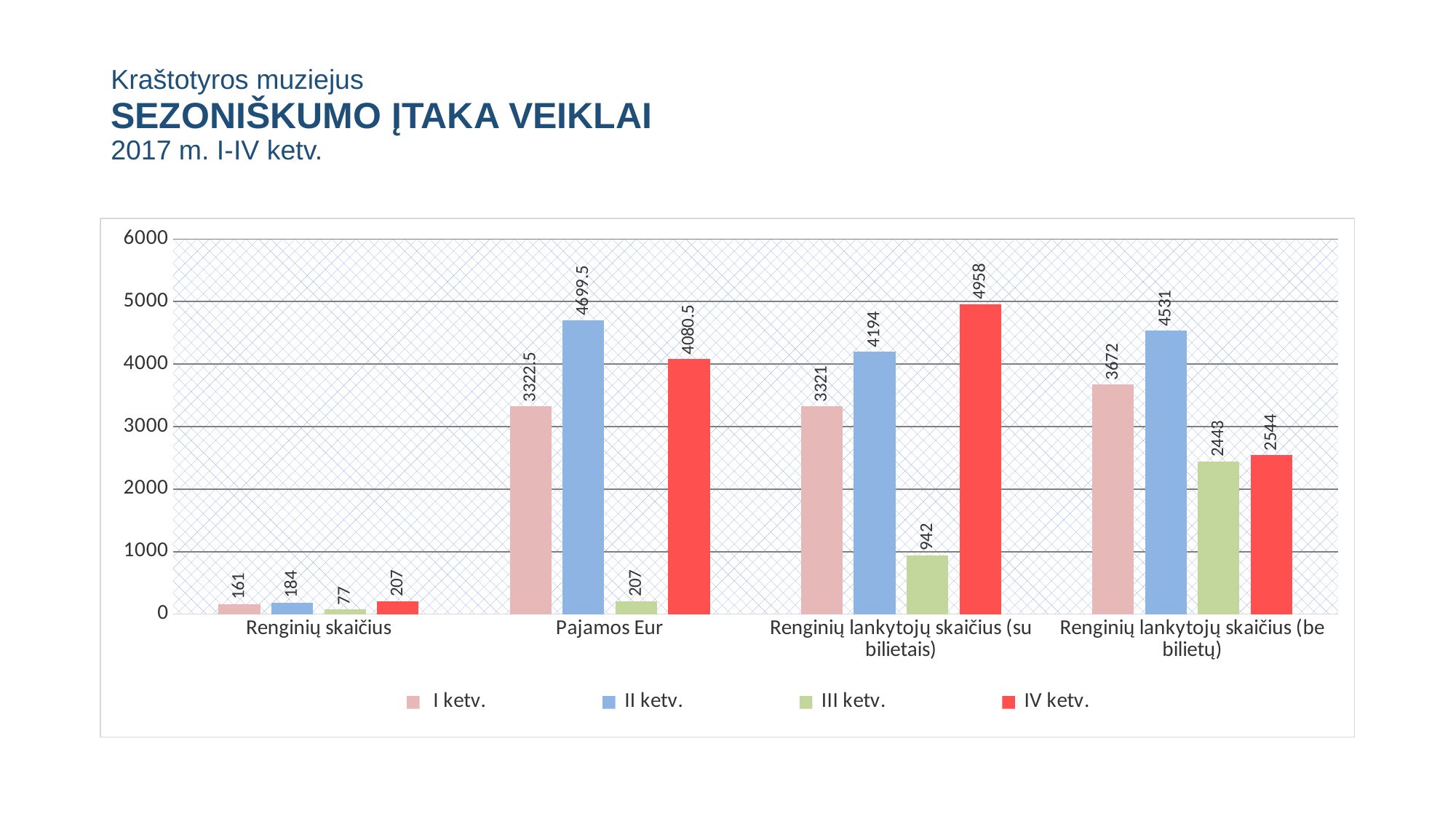
Which quarter has the lowest value in the Pajamos Eur category? III ketv. What is the difference between the II ketv. and I ketv. values in the Renginių lankytojų skaičius (be bilietų) category? 859 How many categories are shown on the x axis? 4 Which quarter has the highest value in the Renginių lankytojų skaičius (su bilietais) category? IV ketv. What kind of chart is shown on the slide? bar chart What is the value for IV ketv. in the Renginių skaičius category? 207 What is the value for III ketv. in the Renginių lankytojų skaičius (su bilietais) category? 942 How many series does the legend list? 4 What is the value for II ketv. in the Pajamos Eur category? 4699.5 What colour represents IV ketv. in the chart? red In the Pajamos Eur category, which is larger: the I ketv. value or the IV ketv. value? IV ketv. Is the value for II ketv. in the Renginių lankytojų skaičius (be bilietų) category greater or less than 4000? greater